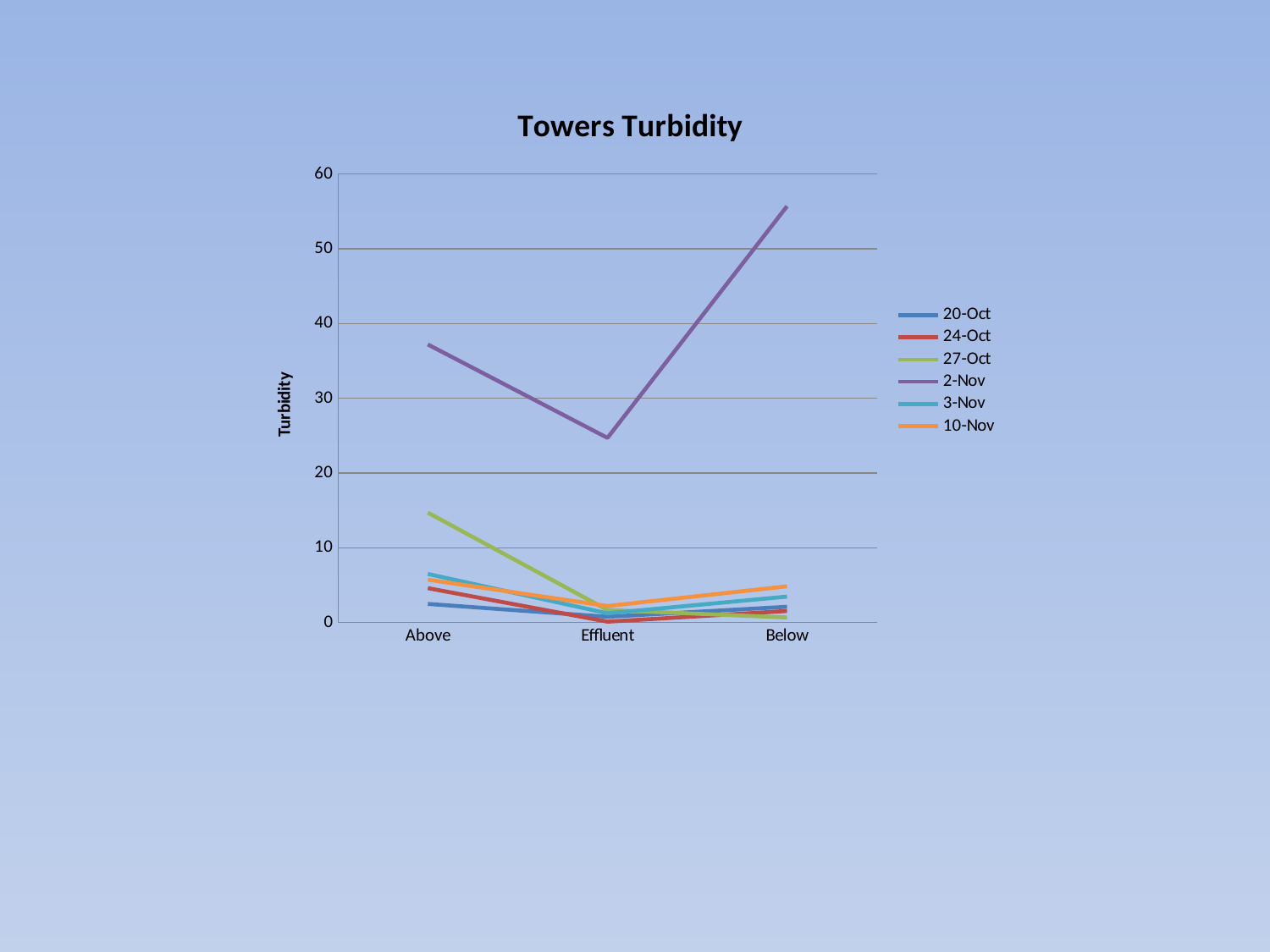
Which series has the highest value at Below? 2-Nov How many categories are shown on the x axis? 3 Is the value for 2-Nov at Effluent greater or less than 20? greater How many series does the legend list? 6 What is the title of the chart? Towers Turbidity What is the label on the vertical axis? Turbidity What kind of chart is shown on the slide? line chart Which series has the highest value at Above? 2-Nov Is the value for 2-Nov at Below greater or less than 50? greater Is the value for 27-Oct at Above greater or less than 10? greater At which category does the 2-Nov series reach its lowest value? Effluent